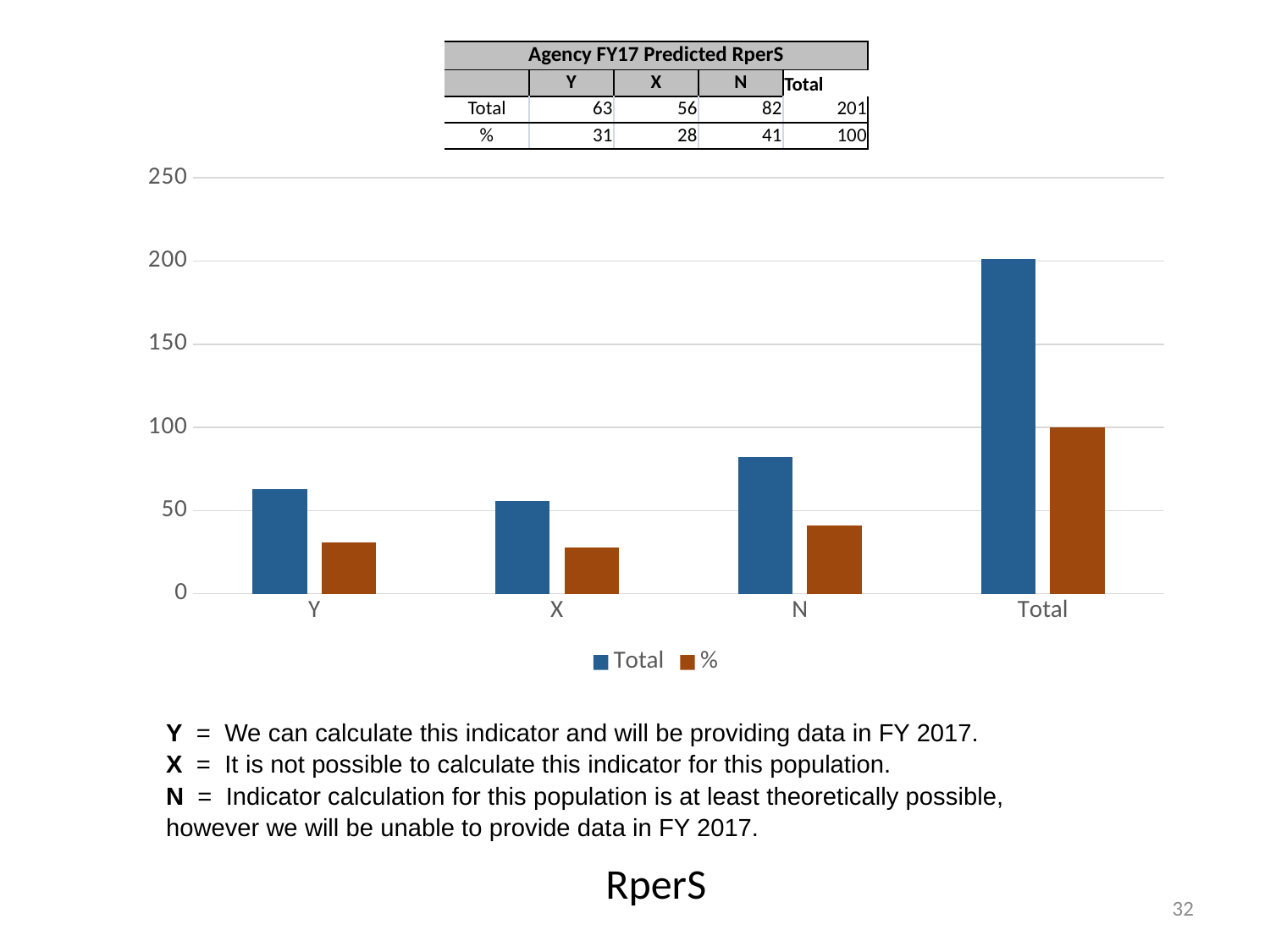
What is the Total value for category N? 82 What is the % value for category Y? 31 What is the difference between the Total values for N and Y? 19 Among Y, X and N, which category has the lowest % value? X What is the Total value for category X? 56 How many series does the chart legend list? 2 What colour are the bars for the % series? orange-brown Which is larger, the Total value for Y or the Total value for X? Y How many categories are shown on the x axis of the chart? 4 What kind of chart is shown on the slide? bar chart Among Y, X and N, which category has the highest Total value? N Is the Total value for the Total category greater or less than 150? greater